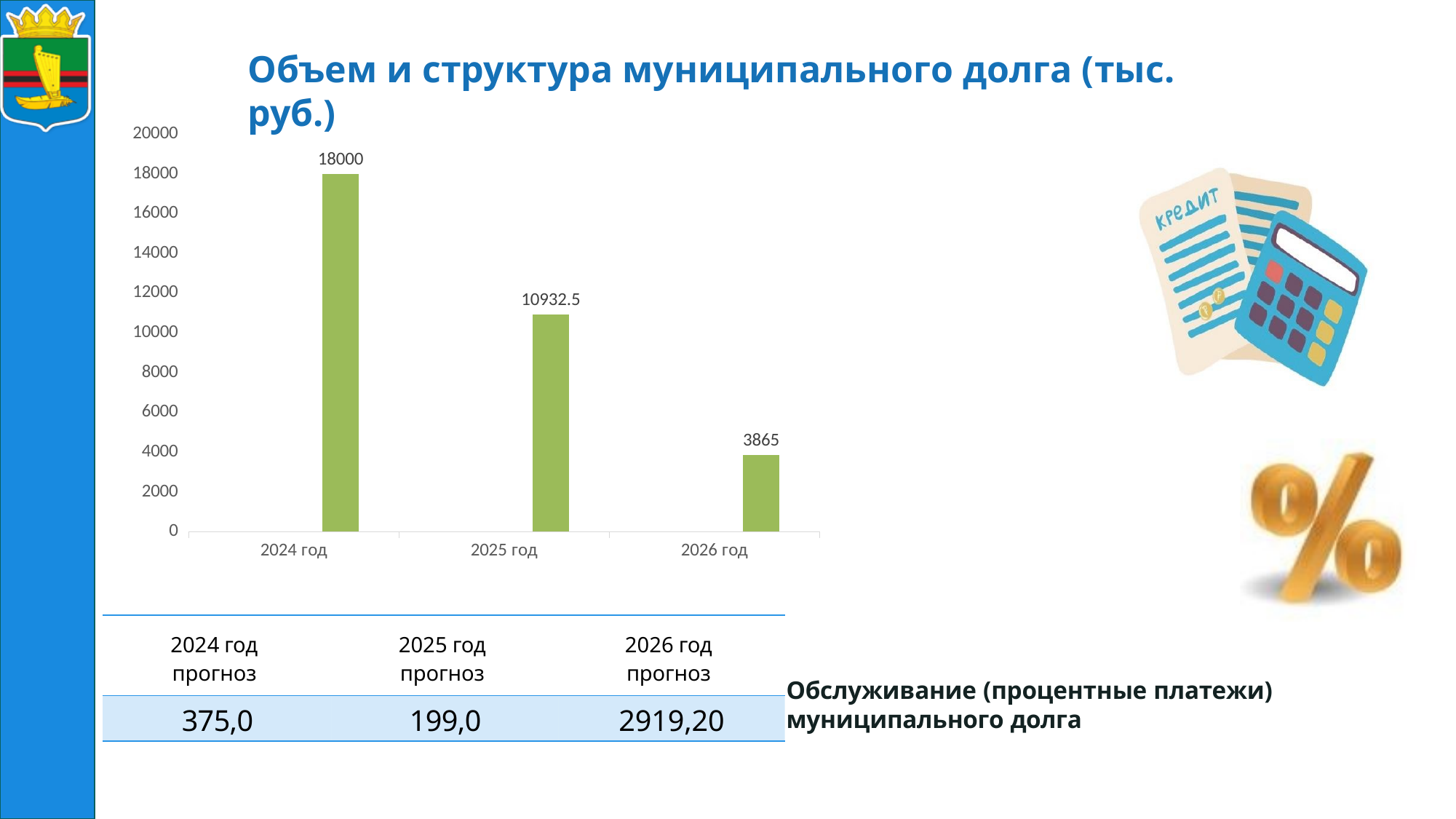
Which year has the lowest value? 2026 год What is the value for 2026 год? 3865 How many categories are shown on the x axis? 3 Is the value for 2025 год greater or less than 10000? greater What is the value for 2025 год? 10932.5 Which is larger, the value for 2025 год or the value for 2026 год? 2025 год What is the difference between the values for 2024 год and 2026 год? 14135 Which year has the highest value? 2024 год What kind of chart is shown on the slide? bar chart What is the difference between the values for 2024 год and 2025 год? 7067.5 What is the value for 2024 год? 18000 Do the values rise or fall from 2024 год to 2026 год? fall